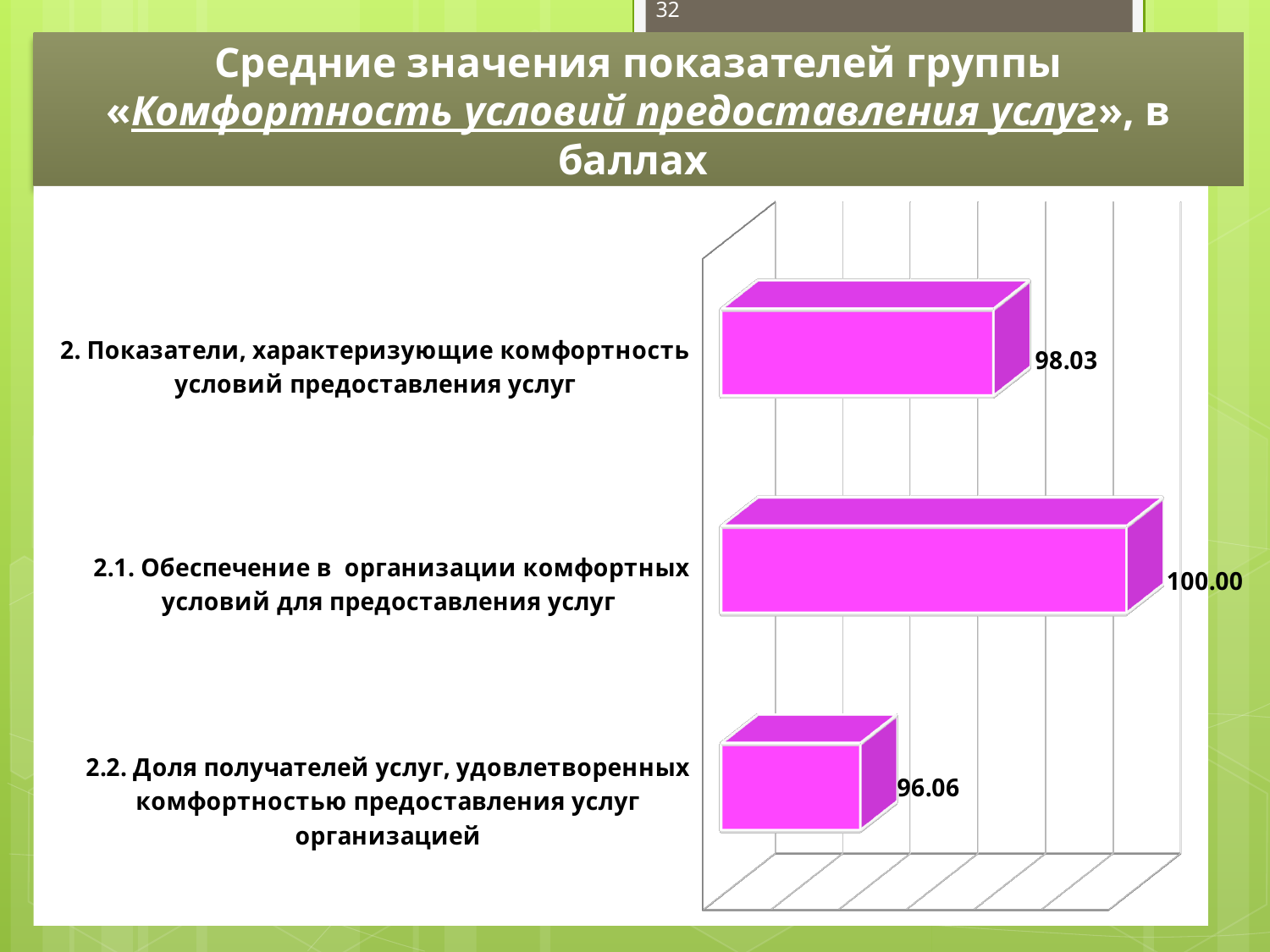
How many categories are shown in the chart? 3 What is the value for "2. Показатели, характеризующие комфортность условий предоставления услуг"? 98.03 What kind of chart is shown on the slide? Bar chart What is the difference between the values for category 2.1 and category 2.2? 3.94 Which category has the highest value? 2.1. Обеспечение в организации комфортных условий для предоставления услуг What colour are the bars in the chart? Magenta (pink) Which is larger: the value for category 2 or the value for category 2.2? Category 2 (98.03) What is the value for "2.2. Доля получателей услуг, удовлетворенных комфортностью предоставления услуг организацией"? 96.06 In what units are the values shown, according to the slide title? В баллах (points) What is the value for "2.1. Обеспечение в организации комфортных условий для предоставления услуг"? 100.00 What is the difference between the values for category 2 and category 2.2? 1.97 Which category has the lowest value? 2.2. Доля получателей услуг, удовлетворенных комфортностью предоставления услуг организацией